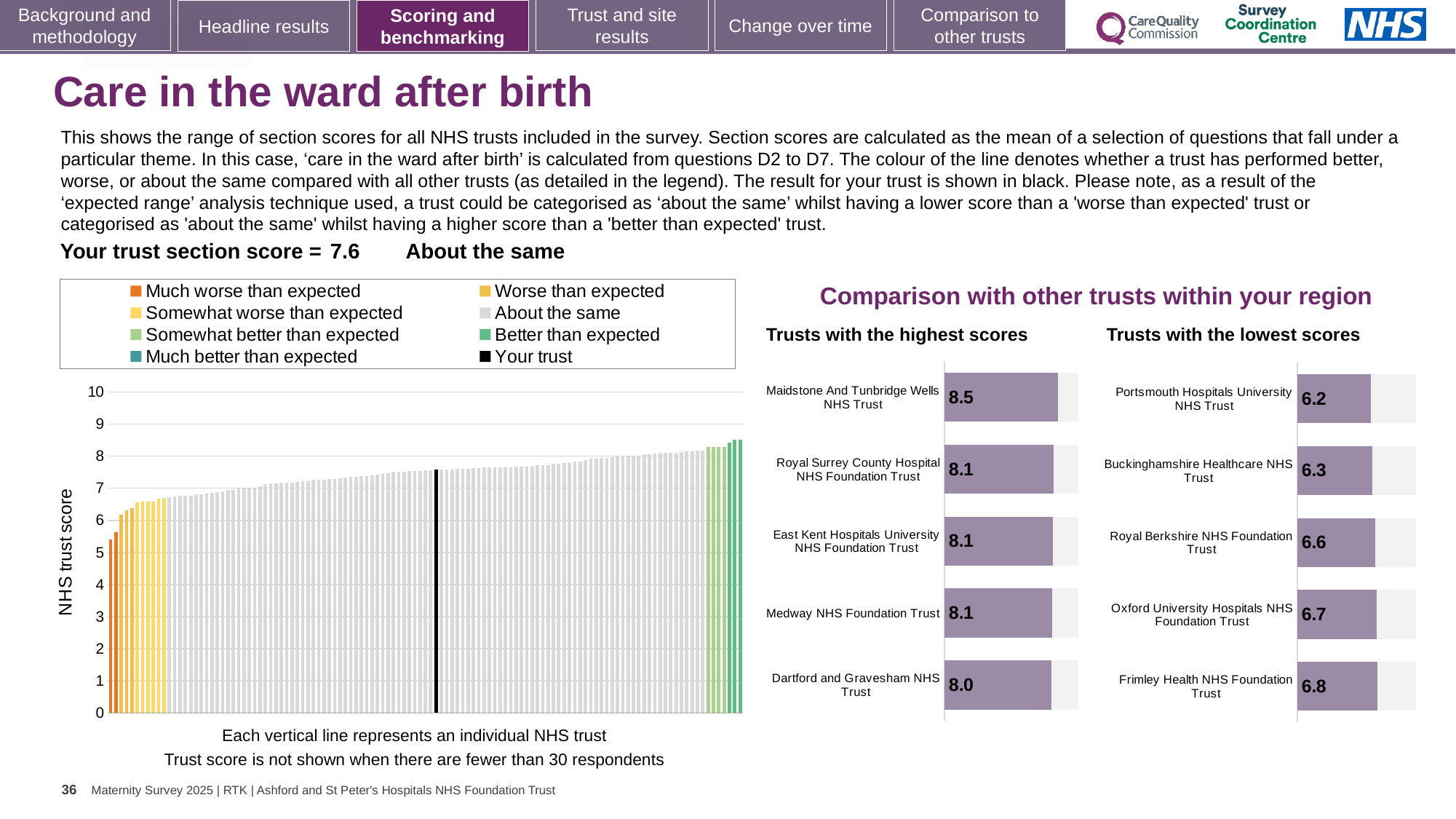
In the 'Trusts with the highest scores' chart, which trust has the lowest score shown? Dartford and Gravesham NHS Trust In the 'Trusts with the lowest scores' chart, which has the higher score: Buckinghamshire Healthcare NHS Trust or Oxford University Hospitals NHS Foundation Trust? Oxford University Hospitals NHS Foundation Trust In the 'Trusts with the lowest scores' chart, what is the score for Royal Berkshire NHS Foundation Trust? 6.6 In the large 'NHS trust score' chart on the left, is the value for the black 'Your trust' bar greater or less than 7? greater In the 'Trusts with the highest scores' chart, what is the score for Maidstone And Tunbridge Wells NHS Trust? 8.5 In the large 'NHS trust score' chart on the left, is the value of the lowest bar greater or less than 6? less How many trusts are shown in the 'Trusts with the highest scores' chart? 5 In the large 'NHS trust score' chart on the left, do the bar values rise or fall from left to right? rise In the 'Trusts with the lowest scores' chart, which trust has the lowest score? Portsmouth Hospitals University NHS Trust How many entries does the legend of the large 'NHS trust score' chart on the left list? 8 In the 'Trusts with the lowest scores' chart, what is the difference between the scores of Frimley Health NHS Foundation Trust and Portsmouth Hospitals University NHS Trust? 0.6 In the 'Trusts with the highest scores' chart, what is the difference between the scores of Maidstone And Tunbridge Wells NHS Trust and Dartford and Gravesham NHS Trust? 0.5